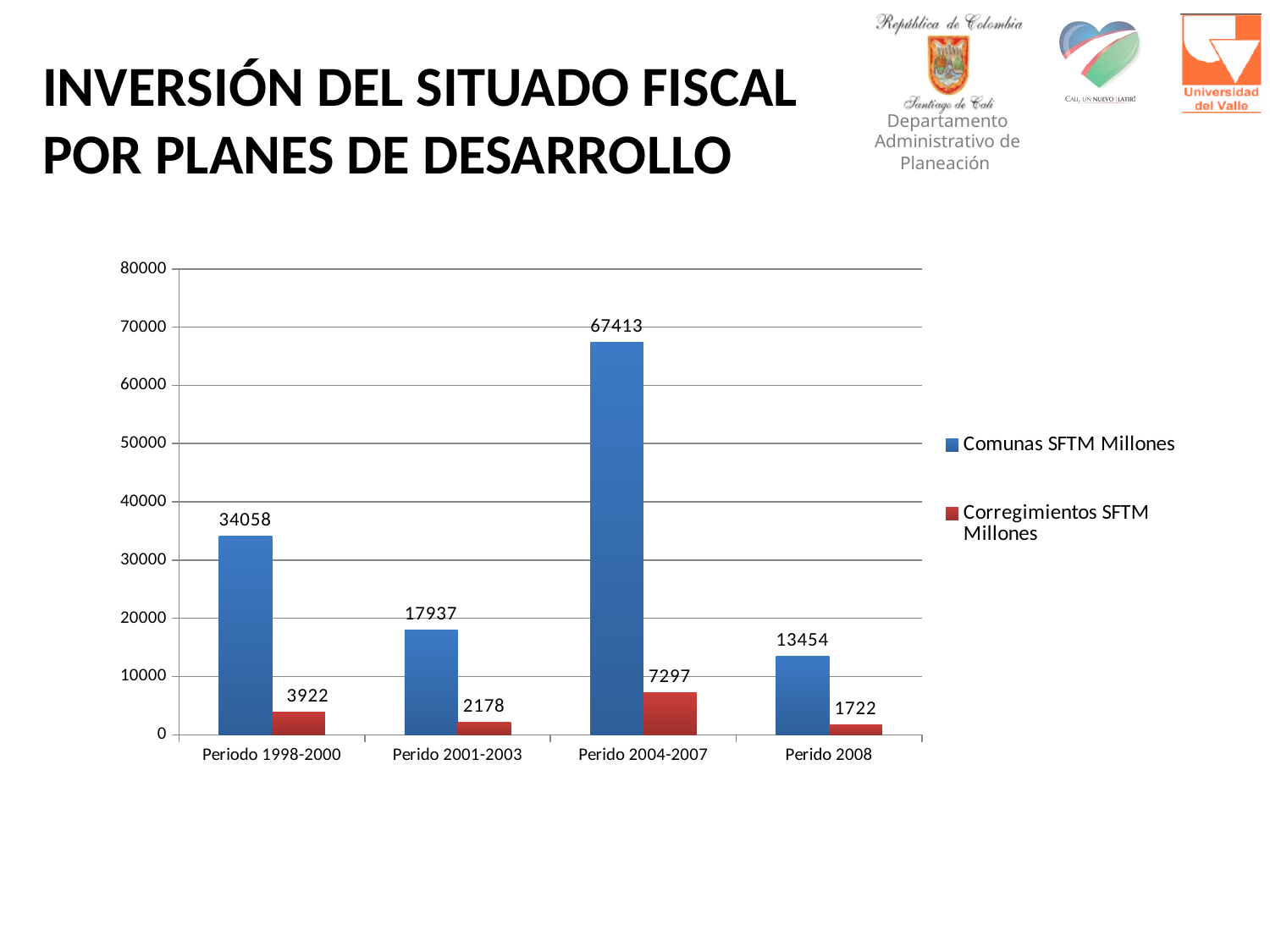
What colour are the bars for Corregimientos SFTM Millones? Red Which is larger: Corregimientos SFTM Millones for Periodo 1998-2000 or for Perido 2001-2003? Periodo 1998-2000 What kind of chart is shown on the slide? Bar chart What is the value of Corregimientos SFTM Millones for Perido 2004-2007? 7297 How many periods are shown on the x axis? 4 What is the difference between Comunas SFTM Millones and Corregimientos SFTM Millones for Perido 2001-2003? 15759 What is the value of Comunas SFTM Millones for Perido 2008? 13454 How many series does the legend list? 2 Which period has the lowest value for Corregimientos SFTM Millones? Perido 2008 Which period has the highest value for Comunas SFTM Millones? Perido 2004-2007 What is the value of Comunas SFTM Millones for Periodo 1998-2000? 34058 Is the value of Comunas SFTM Millones for Perido 2004-2007 greater or less than 60000? greater